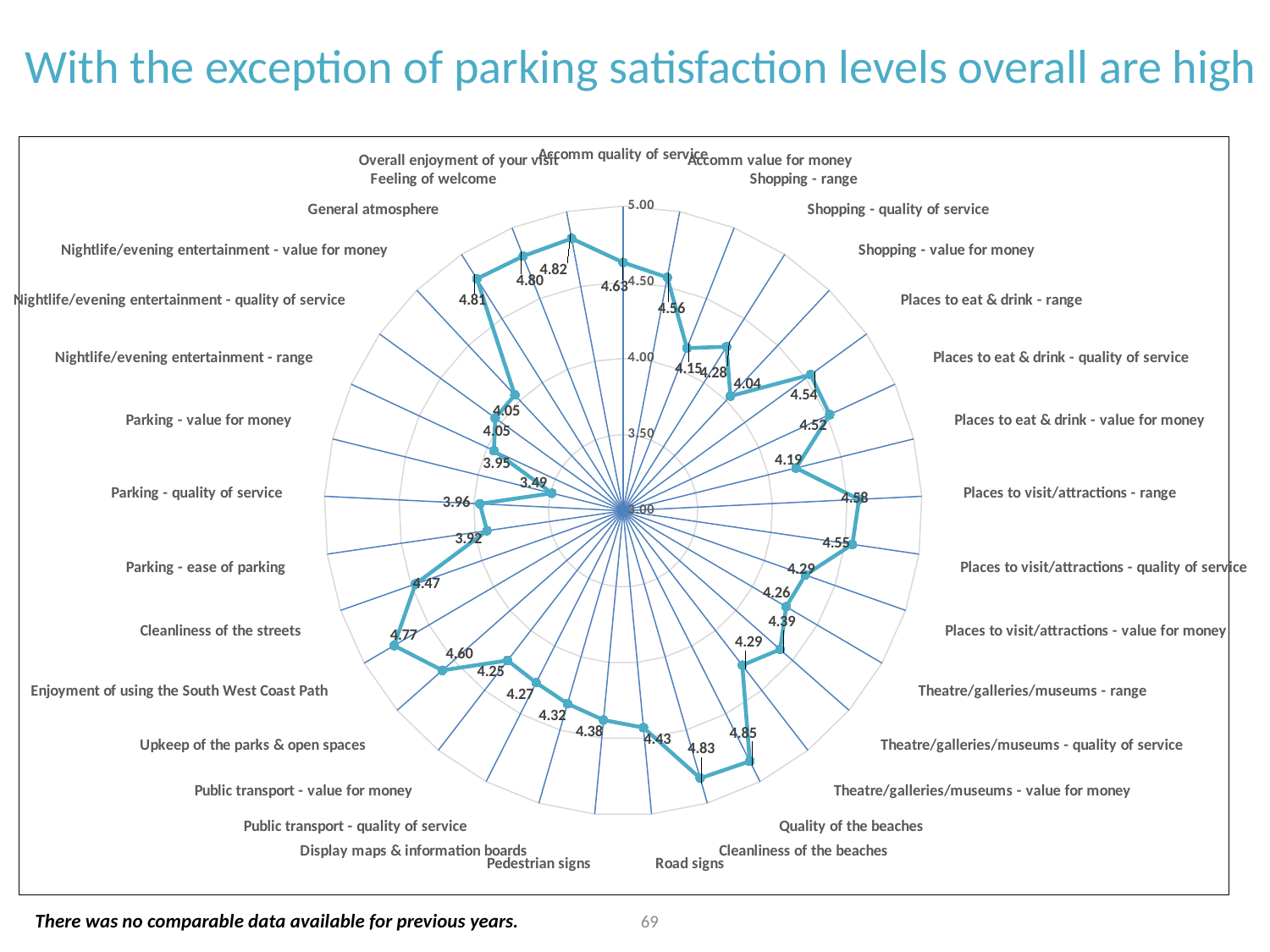
What is the score for Accomm quality of service? 4.63 What is the title of the slide? With the exception of parking satisfaction levels overall are high What is the difference between the highest score (Quality of the beaches) and the lowest score (Parking - value for money)? 1.36 Which category has the lowest satisfaction score? Parking - value for money Is the score for Parking - value for money greater or less than 4.00? less What type of chart is shown on the slide? Radar chart What is the score for Overall enjoyment of your visit? 4.82 What is the score for Parking - value for money? 3.49 What is the score for Enjoyment of using the South West Coast Path? 4.77 Which scores higher, Road signs or Pedestrian signs? Road signs Which category has the highest satisfaction score? Quality of the beaches What is the score for Quality of the beaches? 4.85